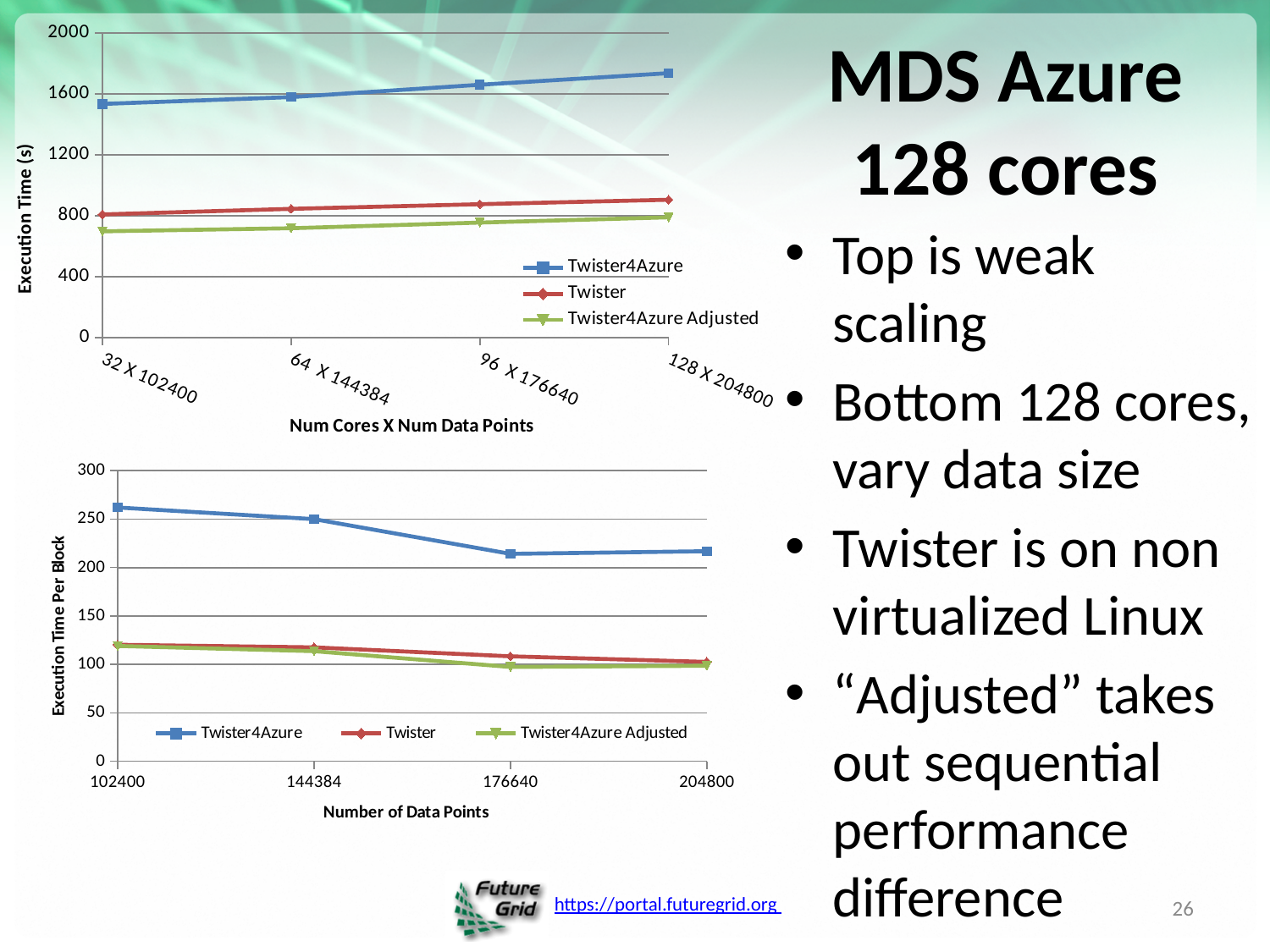
How many series does the legend of the top chart list? 3 In the bottom chart, is the Twister4Azure value at 102400 data points greater or less than 250? greater In the bottom chart, which series has the lowest execution time per block at 204800 data points? Twister4Azure Adjusted How many points are plotted along the x axis of the bottom chart? 4 What kind of chart is the top chart on the slide? line chart In the top chart, does the Twister4Azure line rise or fall along the x axis? rise In the bottom chart, does the Twister4Azure line rise or fall from 102400 to 176640 data points? fall In the bottom chart, is the Twister4Azure Adjusted value at 176640 data points greater or less than 150? less In the top chart, is the Twister value at 32 X 102400 greater or less than 1200? less In the top chart, which series has the highest execution time at 96 X 176640? Twister4Azure What is the x-axis title of the bottom chart? Number of Data Points